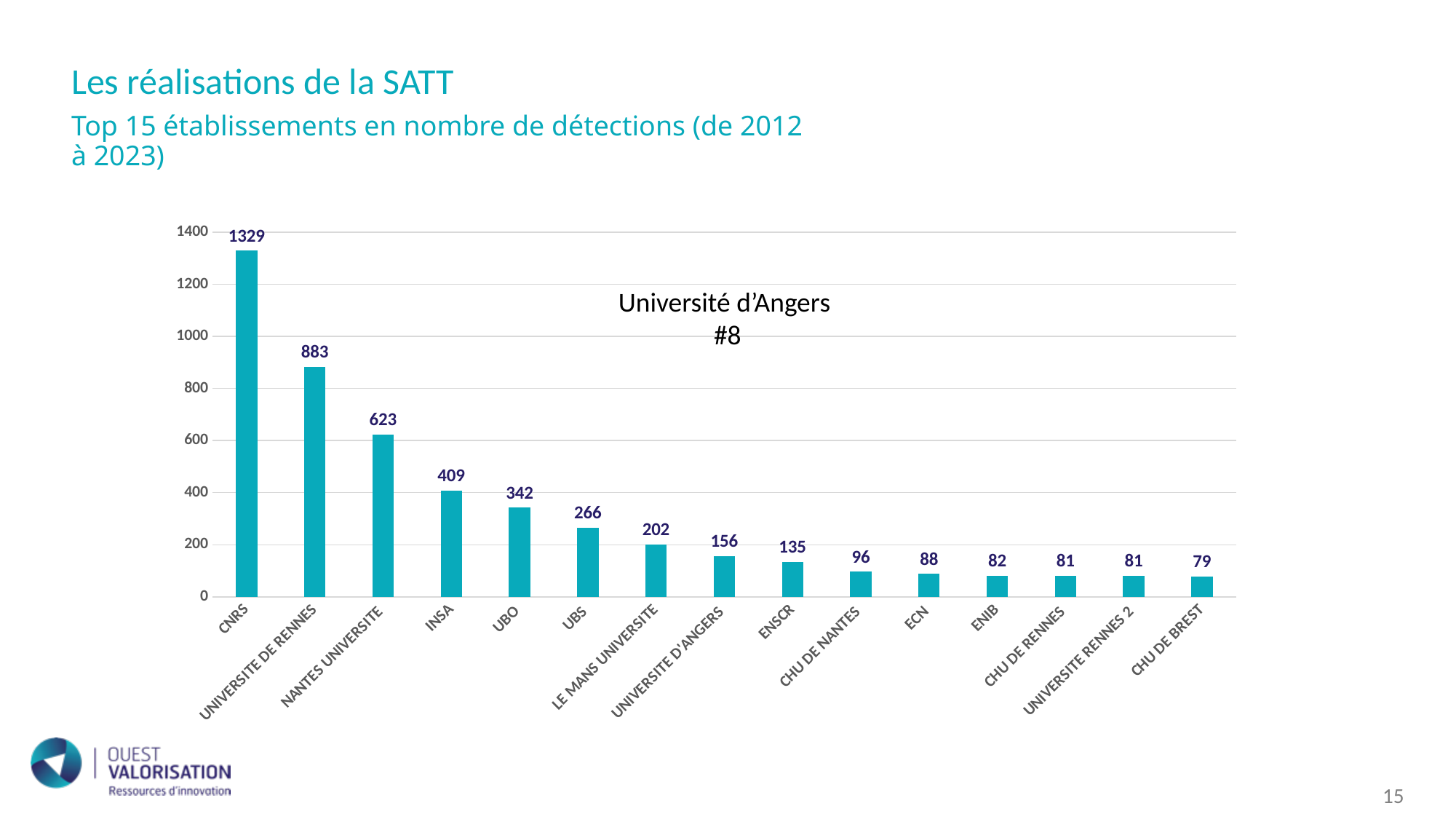
Is the value for ENSCR greater or less than 200? less What is the number of detections for LE MANS UNIVERSITE? 202 Which establishment has the lowest number of detections? CHU DE BREST What is the number of detections for CNRS? 1329 What kind of chart is shown on the slide? bar chart What is the difference in detections between INSA and UBO? 67 Which establishment has the highest number of detections? CNRS How many establishments are shown in the chart? 15 What is the difference in detections between CNRS and UNIVERSITE DE RENNES? 446 Which has more detections, NANTES UNIVERSITE or UBS? NANTES UNIVERSITE What rank does the annotation on the chart give to Université d'Angers? #8 What is the number of detections for UNIVERSITE D'ANGERS? 156